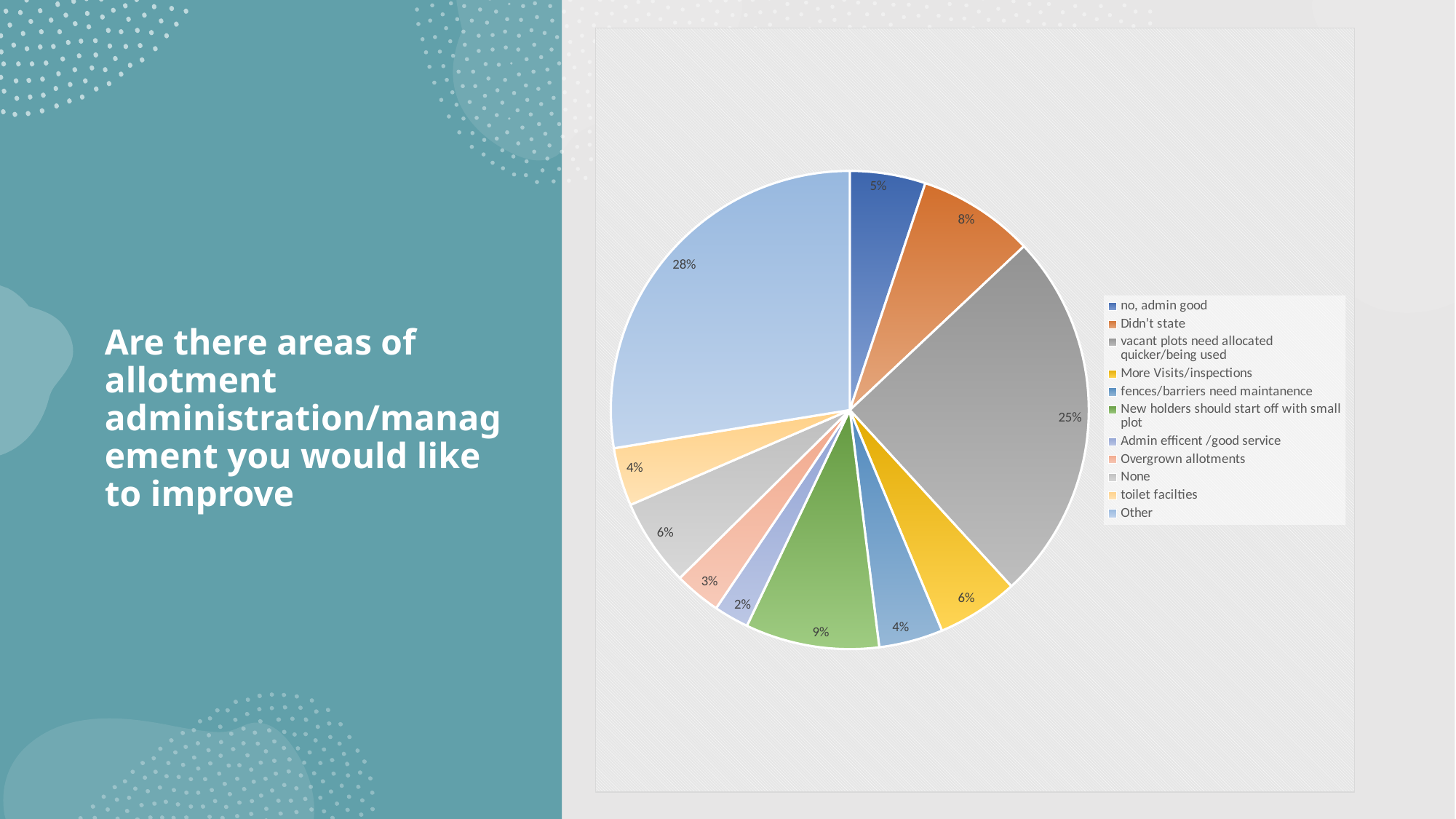
What percentage is shown for "vacant plots need allocated quicker/being used"? 25% What percentage is shown for "Overgrown allotments"? 3% What is the title text shown to the left of the chart? Are there areas of allotment administration/management you would like to improve How many categories does the legend list? 11 What share of the pie is labelled "Other"? 28% Which is larger, the slice for "Didn't state" or the slice for "no, admin good"? Didn't state What percentage is shown for "New holders should start off with small plot"? 9% What percentage is shown for "Didn't state"? 8% Which category has the largest slice of the pie? Other What is the difference in percentage points between "Other" and "vacant plots need allocated quicker/being used"? 3 Which category has the smallest slice of the pie? Admin efficent /good service What kind of chart is shown on the slide? pie chart